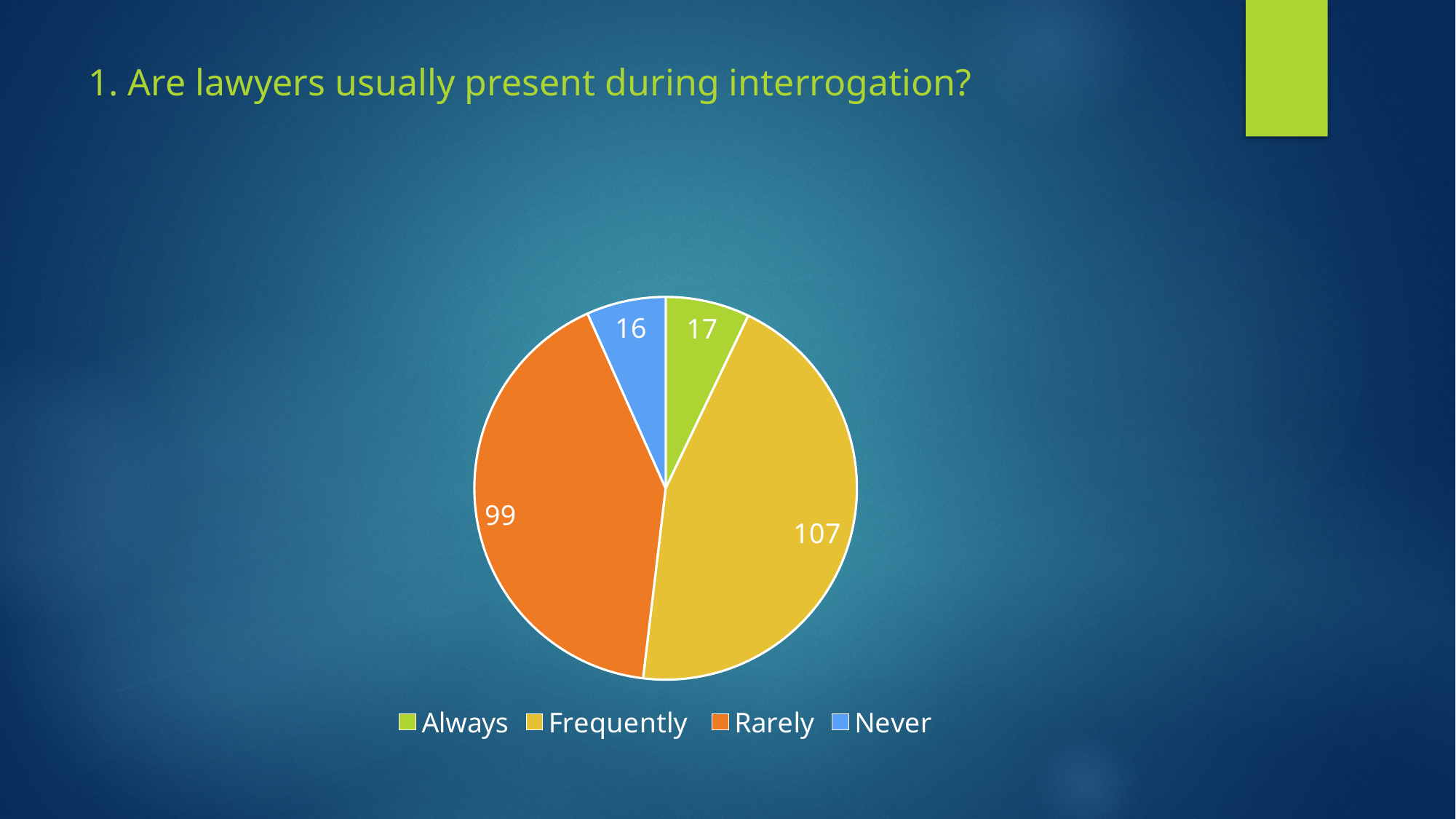
What type of chart is shown on the slide? Pie chart What is the total of all the slice values in the pie chart? 239 What colour is the "Rarely" slice in the pie chart? Orange Which category has the largest slice of the pie? Frequently What is the value shown for the "Never" slice? 16 What is the title of the slide containing the chart? 1. Are lawyers usually present during interrogation? Which category has the smallest slice of the pie? Never How many respondents answered "Frequently"? 107 What is the difference between the "Frequently" and "Rarely" values? 8 What is the value shown for the "Rarely" slice? 99 How many categories does the pie chart show? 4 Which is larger, the value for "Always" or the value for "Never"? Always